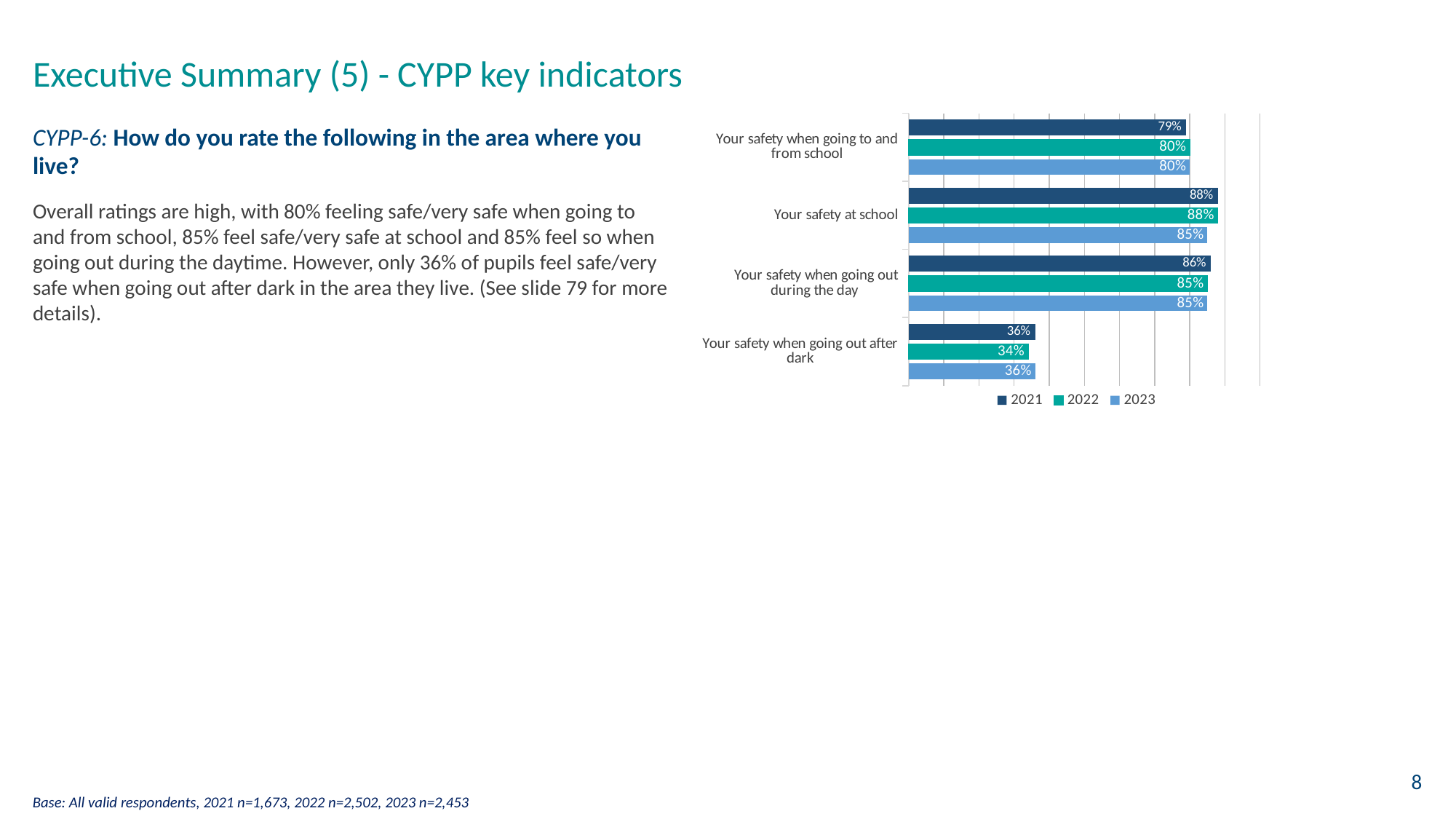
How many categories are shown on the chart? 4 What is the difference between the 2023 values for 'Your safety when going out during the day' and 'Your safety when going out after dark'? 49 percentage points How many series does the legend list? 3 Which category has the lowest 2023 value? Your safety when going out after dark What is the 2021 value for 'Your safety when going out during the day'? 86% What is the 2021 value for 'Your safety at school'? 88% What is the difference between the 2021 and 2023 values for 'Your safety at school'? 3 percentage points Which is larger: the 2021 value for 'Your safety when going to and from school' or the 2021 value for 'Your safety when going out during the day'? Your safety when going out during the day What kind of chart is shown on the slide? Bar chart What is the 2022 value for 'Your safety when going out after dark'? 34% Which category has the highest 2022 value? Your safety at school What is the 2023 value for 'Your safety when going to and from school'? 80%